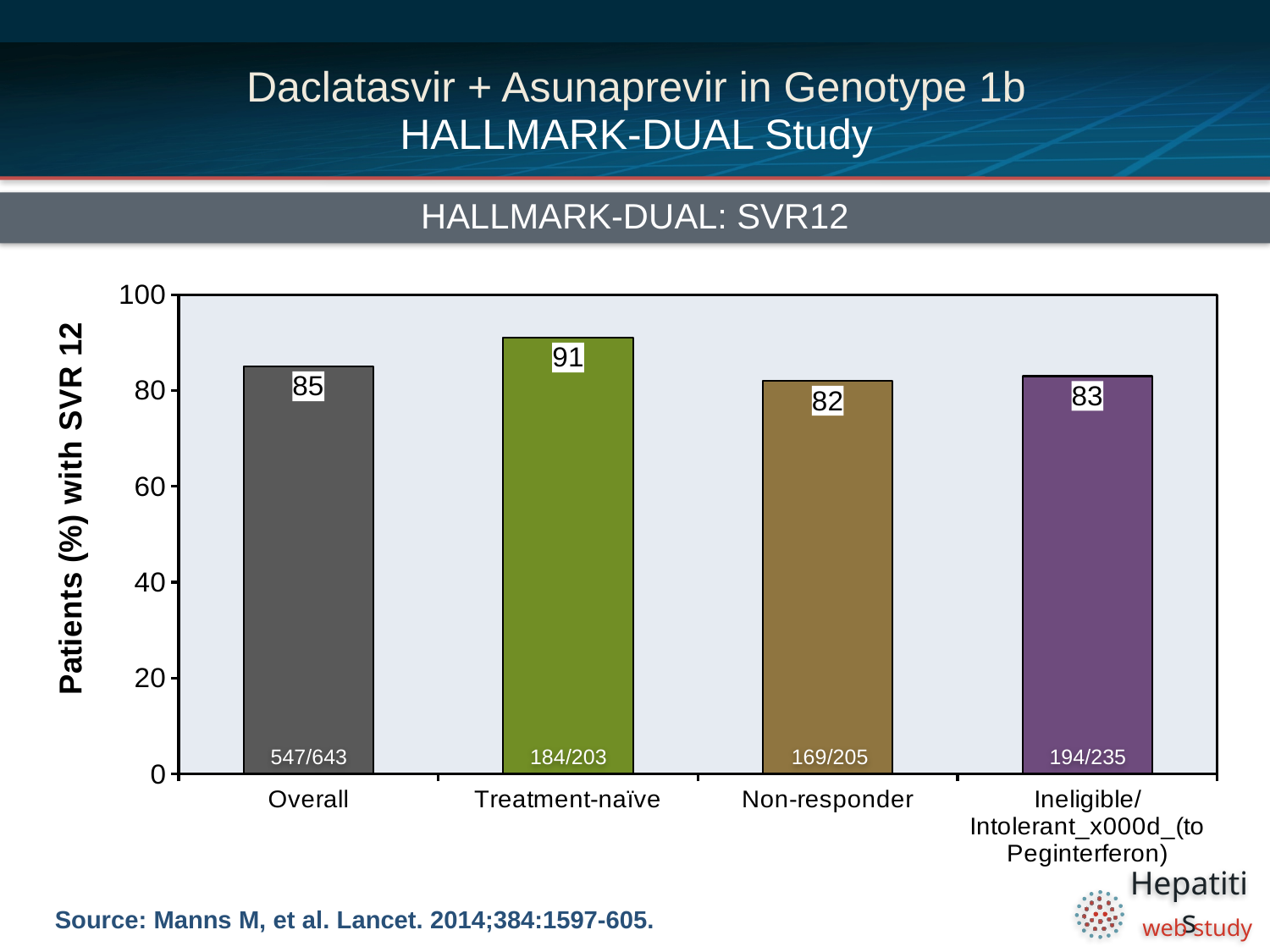
Which group has the highest SVR12 rate? Treatment-naïve How many patient groups are shown on the chart? 4 Which group has the lowest SVR12 rate? Non-responder What is the difference between the SVR12 values for Treatment-naïve and Non-responder? 9 What kind of chart is shown on the slide? Bar chart Which is larger, the SVR12 value for Overall or for Treatment-naïve? Treatment-naïve Is the SVR12 value for Non-responder greater or less than 80? greater What fraction of patients is printed at the base of the Overall bar? 547/643 What is the SVR12 value for the Non-responder group? 82 What is the difference between the SVR12 values for Overall and Ineligible/Intolerant (to Peginterferon)? 2 What is the SVR12 value for the Overall group? 85 What is the SVR12 value for the Treatment-naïve group? 91